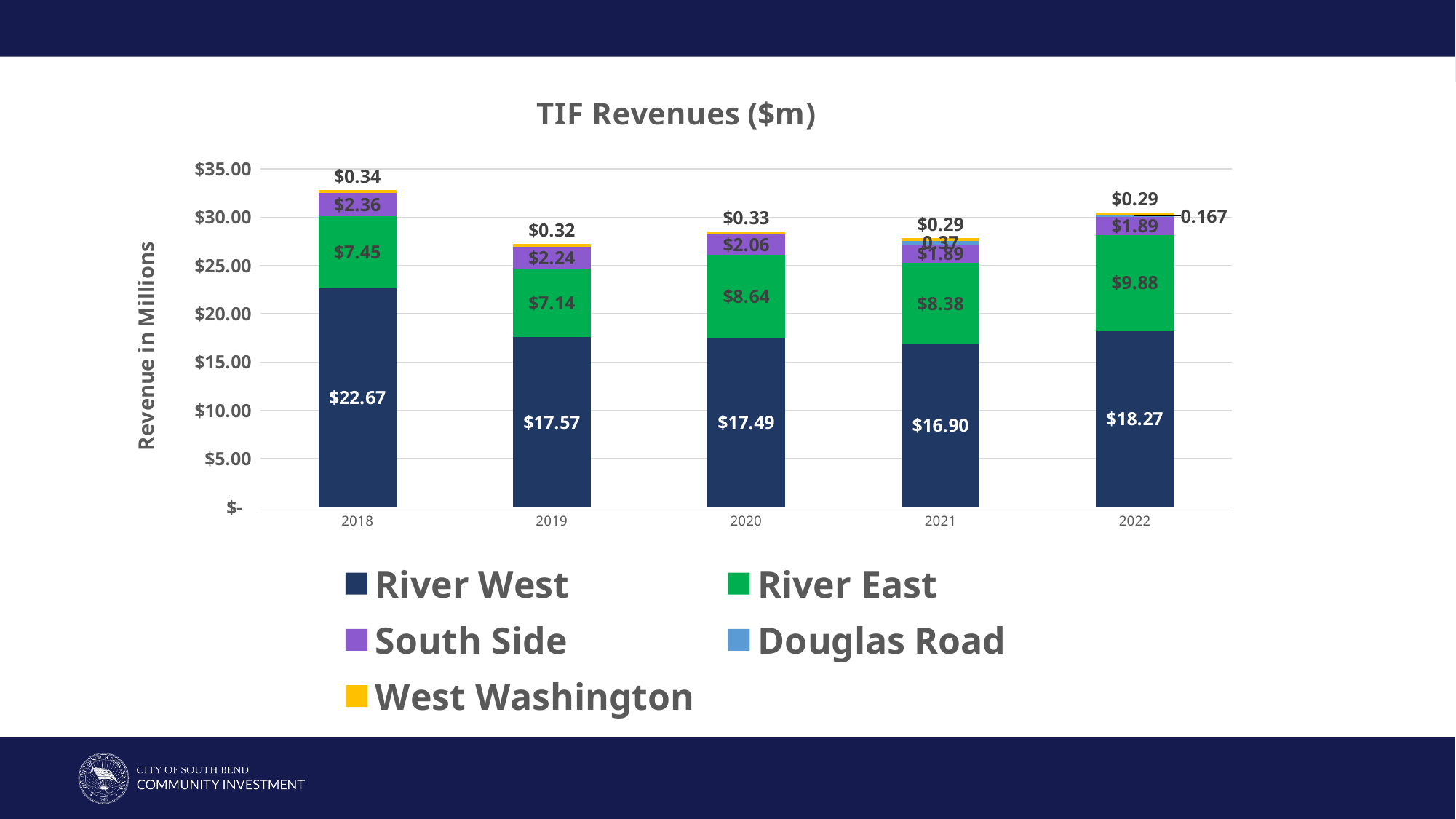
What is the difference between the River East revenue in 2022 and in 2018? $2.43 What is the River West revenue in 2018? $22.67 What is the West Washington revenue in 2018? $0.34 In which year is the River West revenue highest? 2018 What is the South Side revenue in 2019? $2.24 How many series does the legend list? 5 What is the title of the chart? TIF Revenues ($m) How many years are shown on the x axis? 5 What kind of chart is shown on the slide? Stacked bar chart What is the River East revenue in 2022? $9.88 In which year is the River West revenue lowest? 2021 Which year has the larger River East revenue, 2020 or 2021? 2020